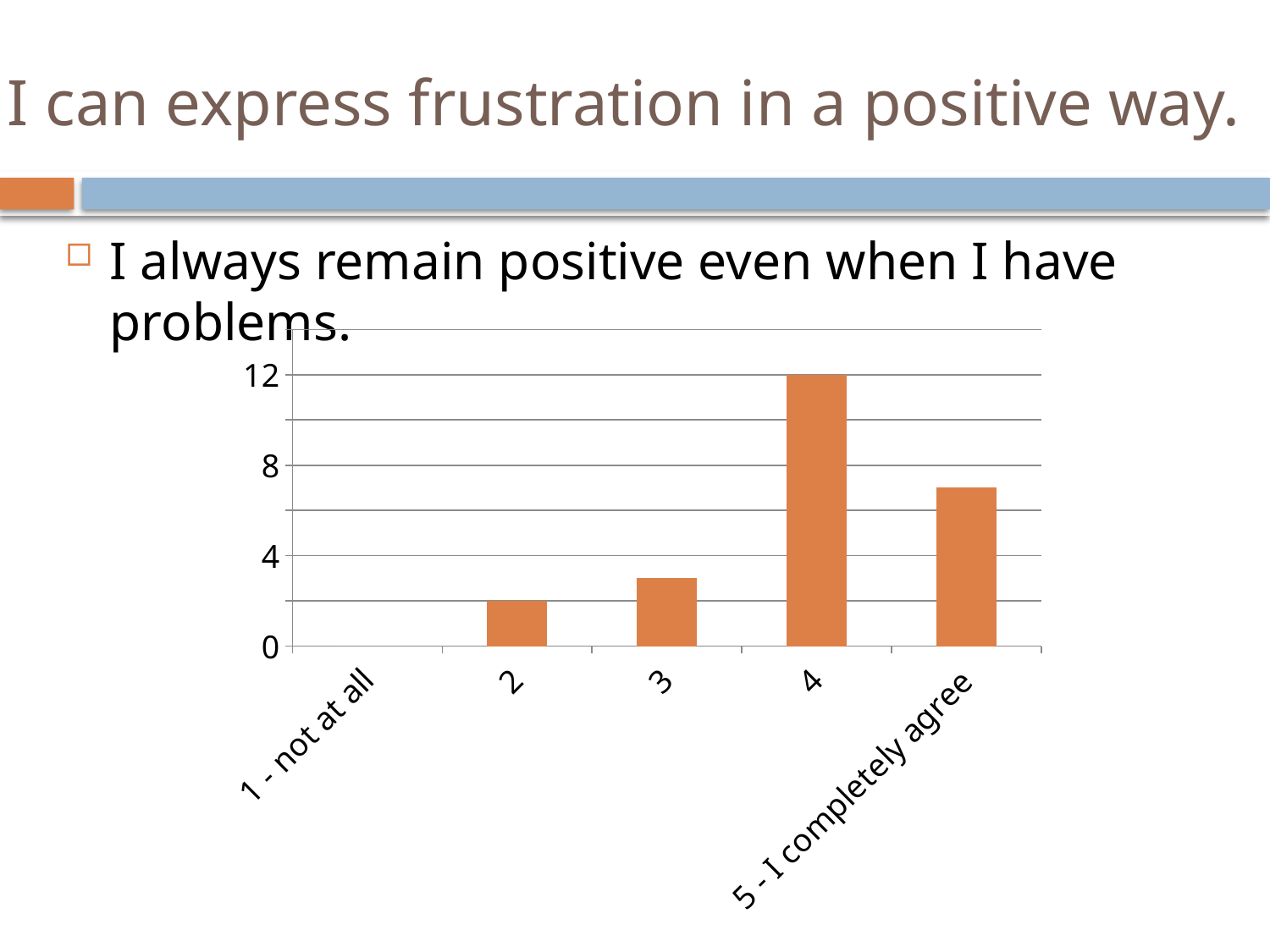
Is the value for "5 - I completely agree" greater or less than 8? less What is the label of the first category on the x axis? 1 - not at all Is the value for category 2 greater or less than 4? less How many categories are shown on the x axis of the chart? 5 Which category has the lowest value in the chart? 1 - not at all Which is larger, the value for category 4 or the value for "5 - I completely agree"? 4 Which category has the highest value in the chart? 4 Is the value for "5 - I completely agree" greater or less than 4? greater What is the value for category 4? 12 Do the values rise or fall from category 2 to category 4? rise What kind of chart is shown on the slide? bar chart